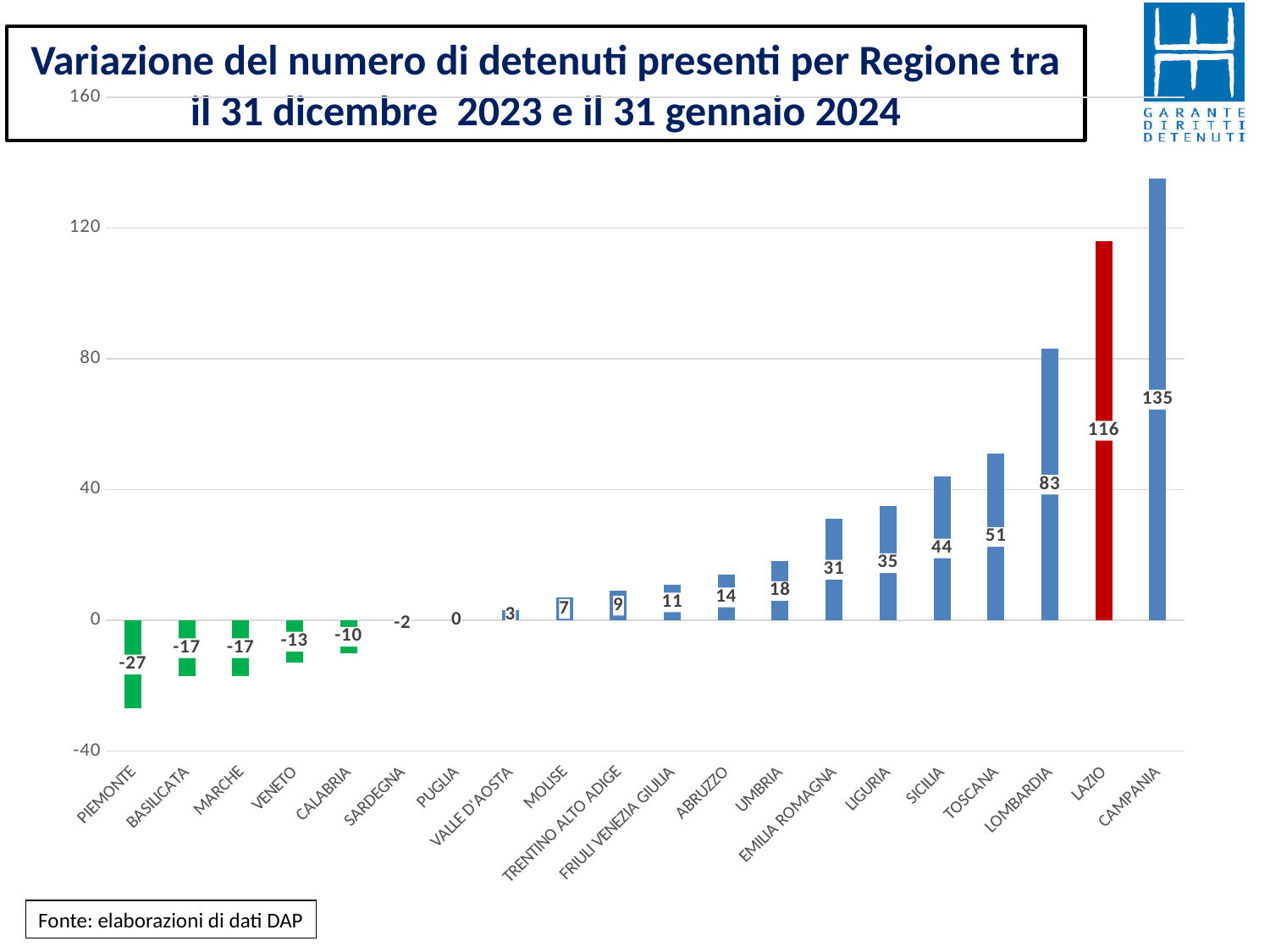
What is the value for Piemonte? -27 Which region has the highest value? Campania What is the difference between the values for Campania and Lazio? 19 What kind of chart is shown on the slide? bar chart Do the values rise or fall from left to right along the x axis? rise How many regions are shown on the x axis? 20 What is the value for Sardegna? -2 What is the value for Lombardia? 83 What is the value for Lazio? 116 Which is larger, the value for Sicilia or the value for Toscana? Toscana Which region has the lowest value? Piemonte Is the value for Campania greater or less than 120? greater